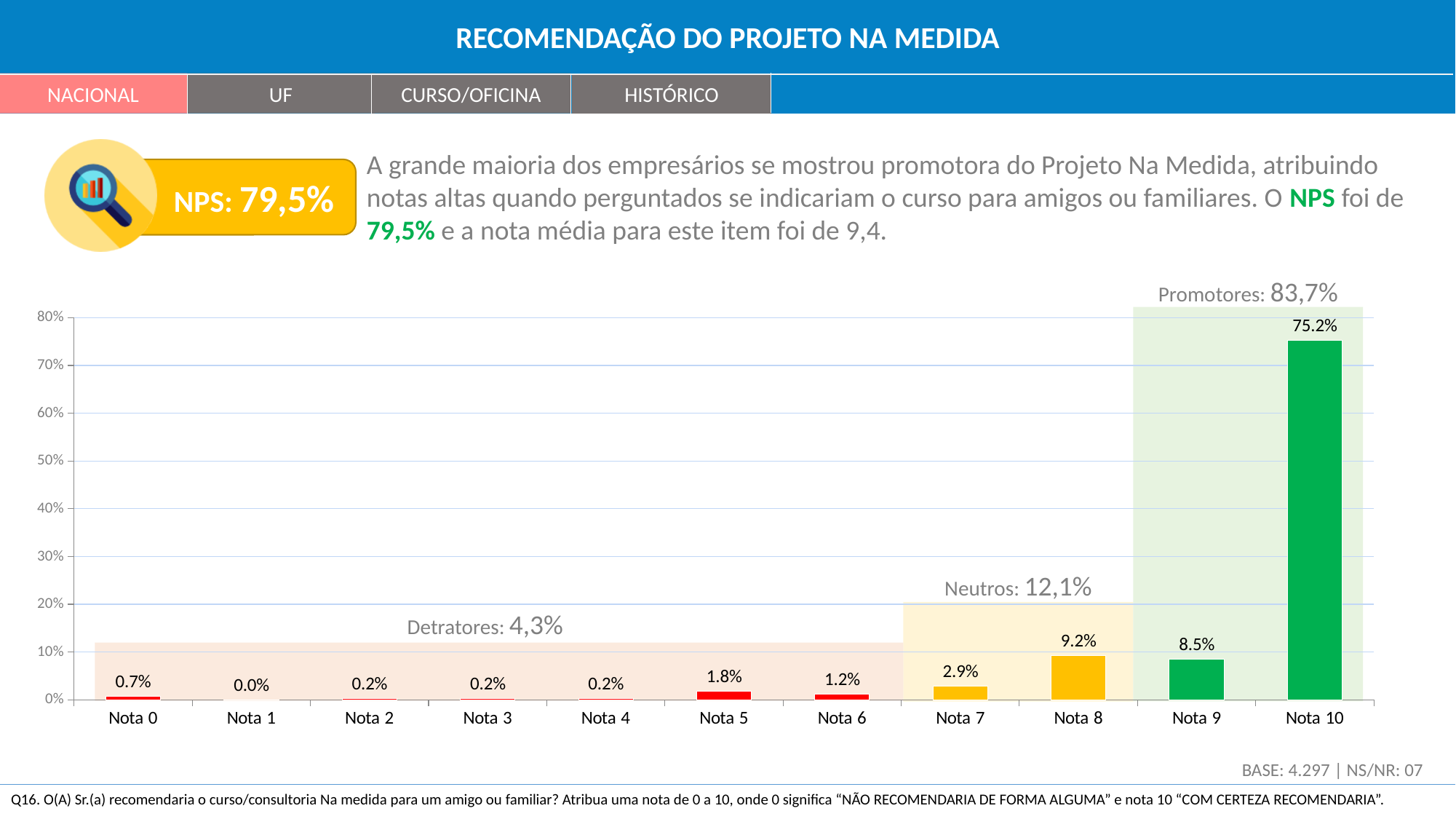
What is the difference between the values for Nota 10 and Nota 8? 66.0% Is the value for Nota 10 greater or less than 70%? greater What is the value for Nota 5? 1.8% How many categories are shown on the x axis? 11 Which category has the lowest value? Nota 1 What is the value for Nota 10? 75.2% What kind of chart is shown on the slide? bar chart What is the value for Nota 8? 9.2% What is the difference between the values for Nota 8 and Nota 9? 0.7% What percentage is shown for the Promotores group on the chart? 83,7% Which category has the highest value? Nota 10 Which is larger, the value for Nota 5 or the value for Nota 6? Nota 5